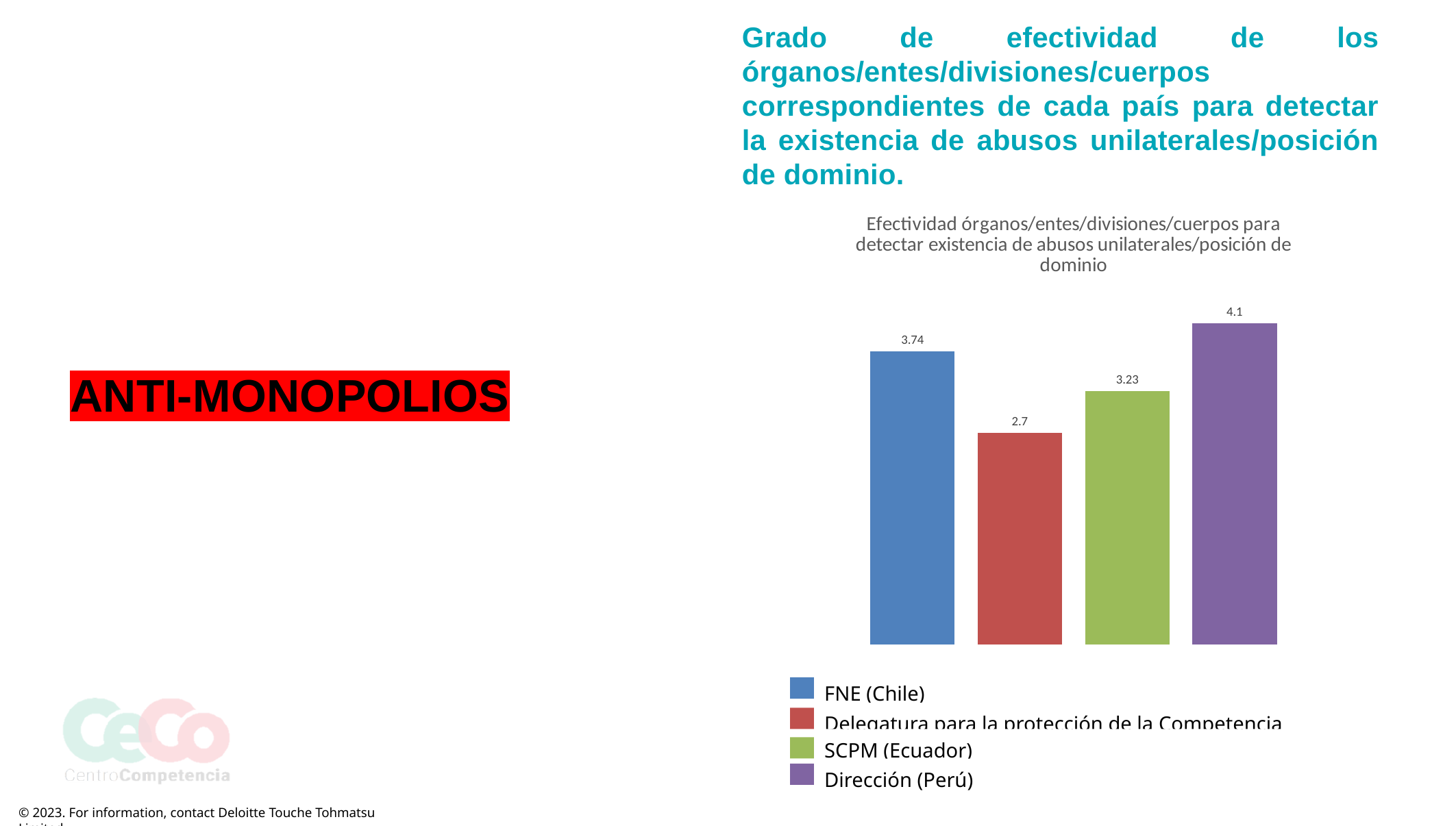
Which entity has the lowest value? Delegatura para la protección de la Competencia What is the value for FNE (Chile)? 3.74 What is the difference between the values for Dirección (Perú) and FNE (Chile)? 0.36 What is the difference between the values for SCPM (Ecuador) and the Delegatura para la protección de la Competencia? 0.53 Which entity has the highest value? Dirección (Perú) Which has a larger value, FNE (Chile) or SCPM (Ecuador)? FNE (Chile) How many bars are shown in the chart? 4 What colour is the bar for Dirección (Perú)? Purple What is the value for SCPM (Ecuador)? 3.23 What kind of chart is shown? Bar chart What is the value for the red bar (Delegatura para la protección de la Competencia)? 2.7 What is the value for Dirección (Perú)? 4.1